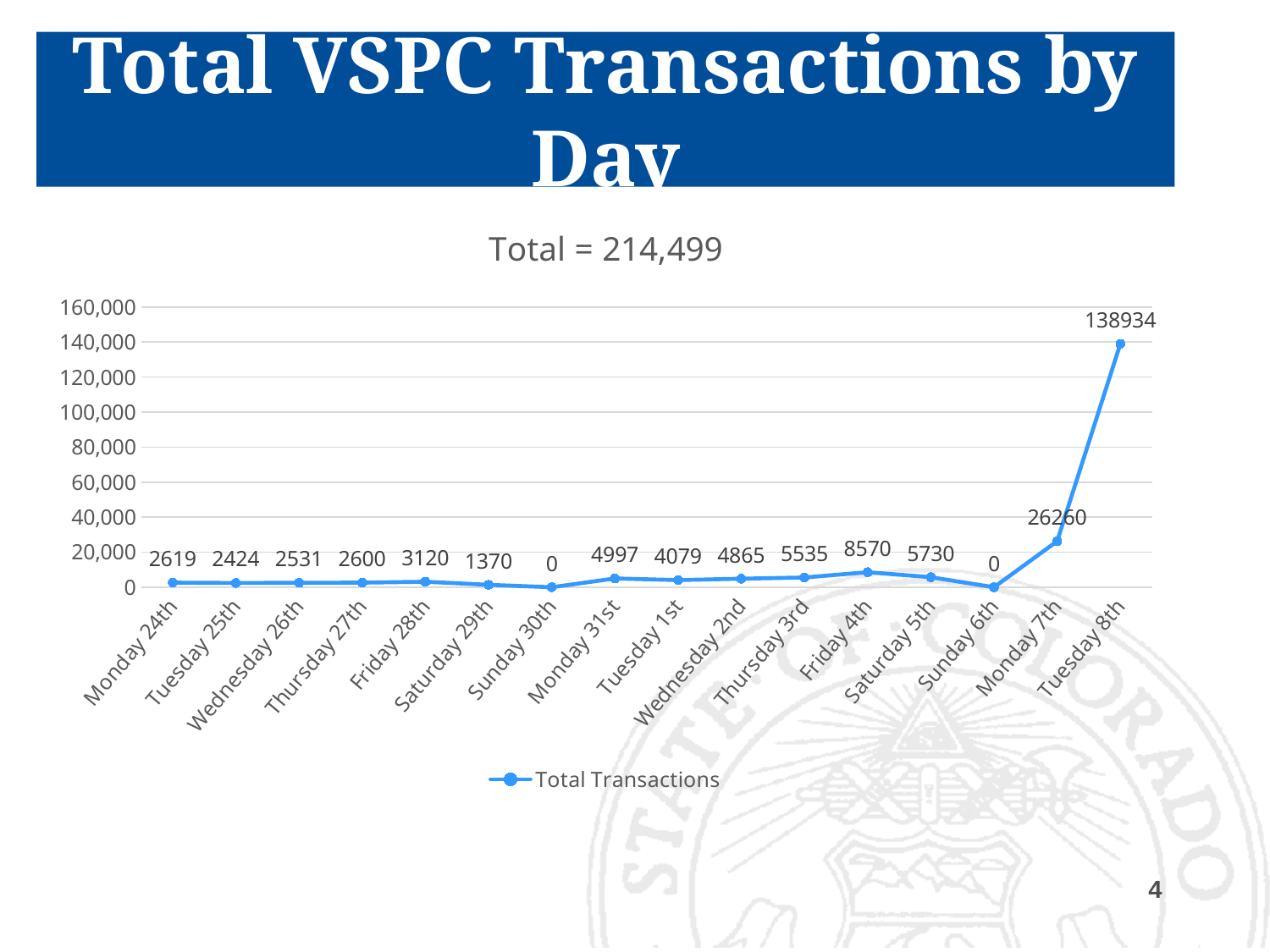
Which day has the highest number of total transactions? Tuesday 8th Which is larger, the value for Friday 4th or the value for Saturday 5th? Friday 4th How many days are plotted on the x axis? 16 What is the value for Monday 7th? 26260 How many series does the legend list? 1 What is the value for Tuesday 8th? 138934 What is the difference between the values for Tuesday 8th and Monday 7th? 112674 What is the value for Friday 4th? 8570 What total is stated in the chart title above the plot? 214,499 What is the value for Saturday 29th? 1370 What type of chart is shown on the slide? Line chart Is the value for Monday 7th greater or less than 40,000? less